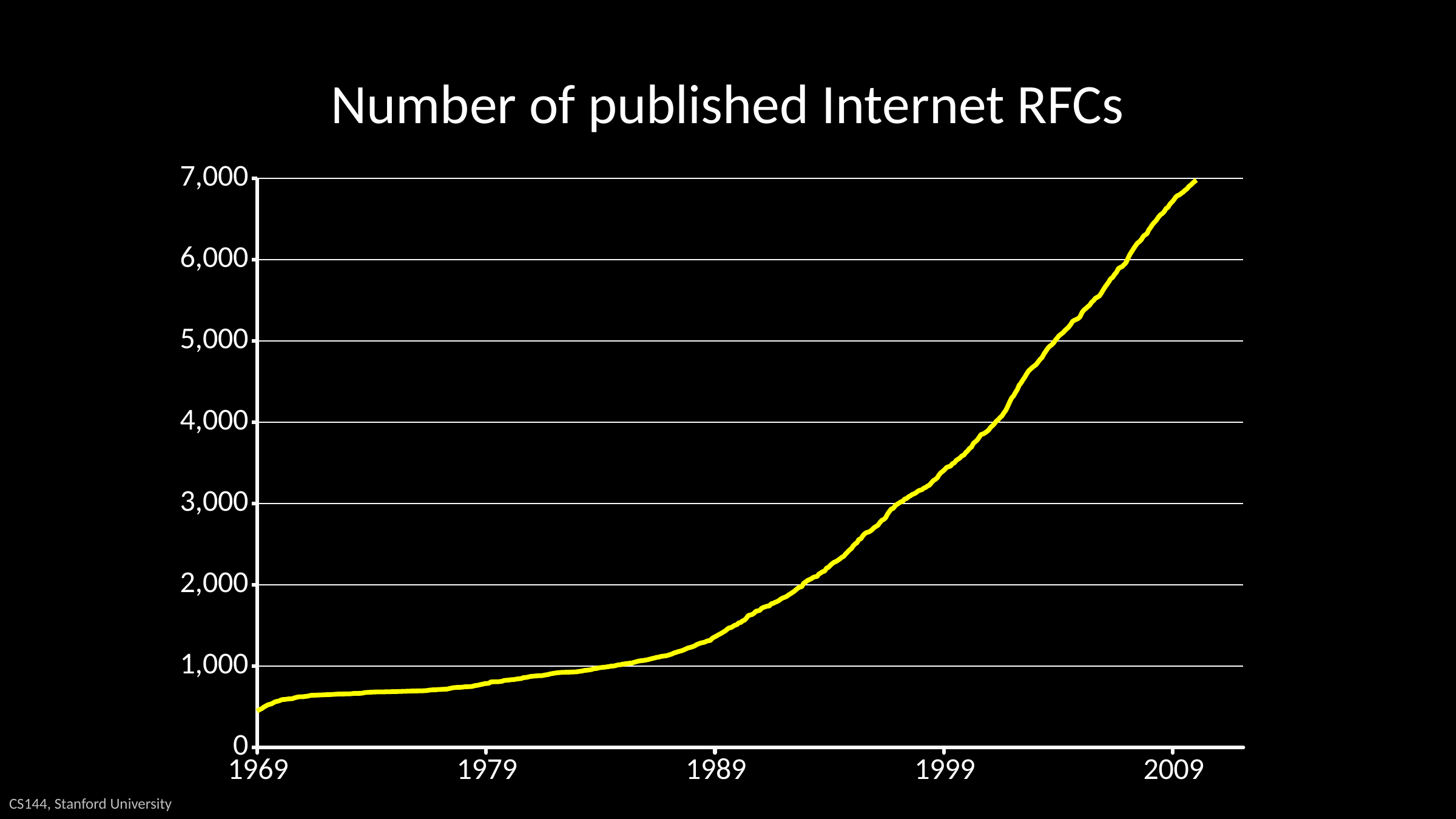
Do the values rise or fall from 1969 to 2009? rise Is the value for 1979 greater or less than 1,000? less Is the value for 2009 greater or less than 6,000? greater Which labelled year on the x axis has the lowest value? 1969 Is the value for 1989 greater or less than 1,000? greater What is the title of the chart? Number of published Internet RFCs What colour is the plotted line? yellow How many year labels are shown on the x axis? 5 What kind of chart is shown on the slide? line chart Which labelled year on the x axis has the higher value, 1979 or 1999? 1999